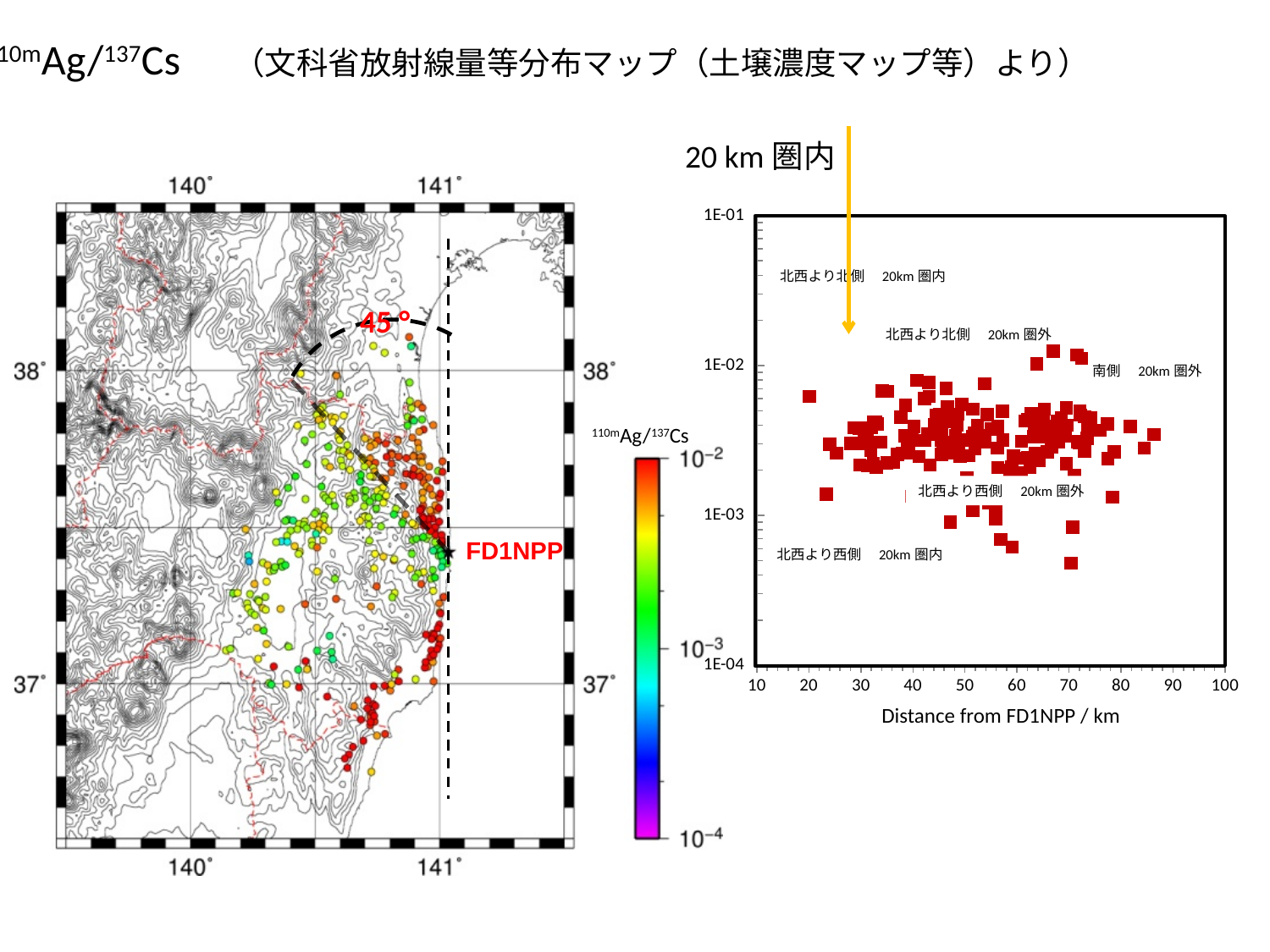
On the right-hand scatter chart, what is the title of the x axis? Distance from FD1NPP / km On the left-hand map, what value is shown at the top of the colour bar? 10^-2 On the right-hand scatter chart, is the lowest plotted value greater or less than 1E-03? less On the right-hand scatter chart, are most of the plotted points above or below 1E-02? below On the right-hand scatter chart, what is the highest tick label on the y axis? 1E-01 On the right-hand scatter chart, is the highest plotted value greater or less than 1E-02? greater What kind of chart is the right-hand chart with the x axis 'Distance from FD1NPP / km'? scatter chart